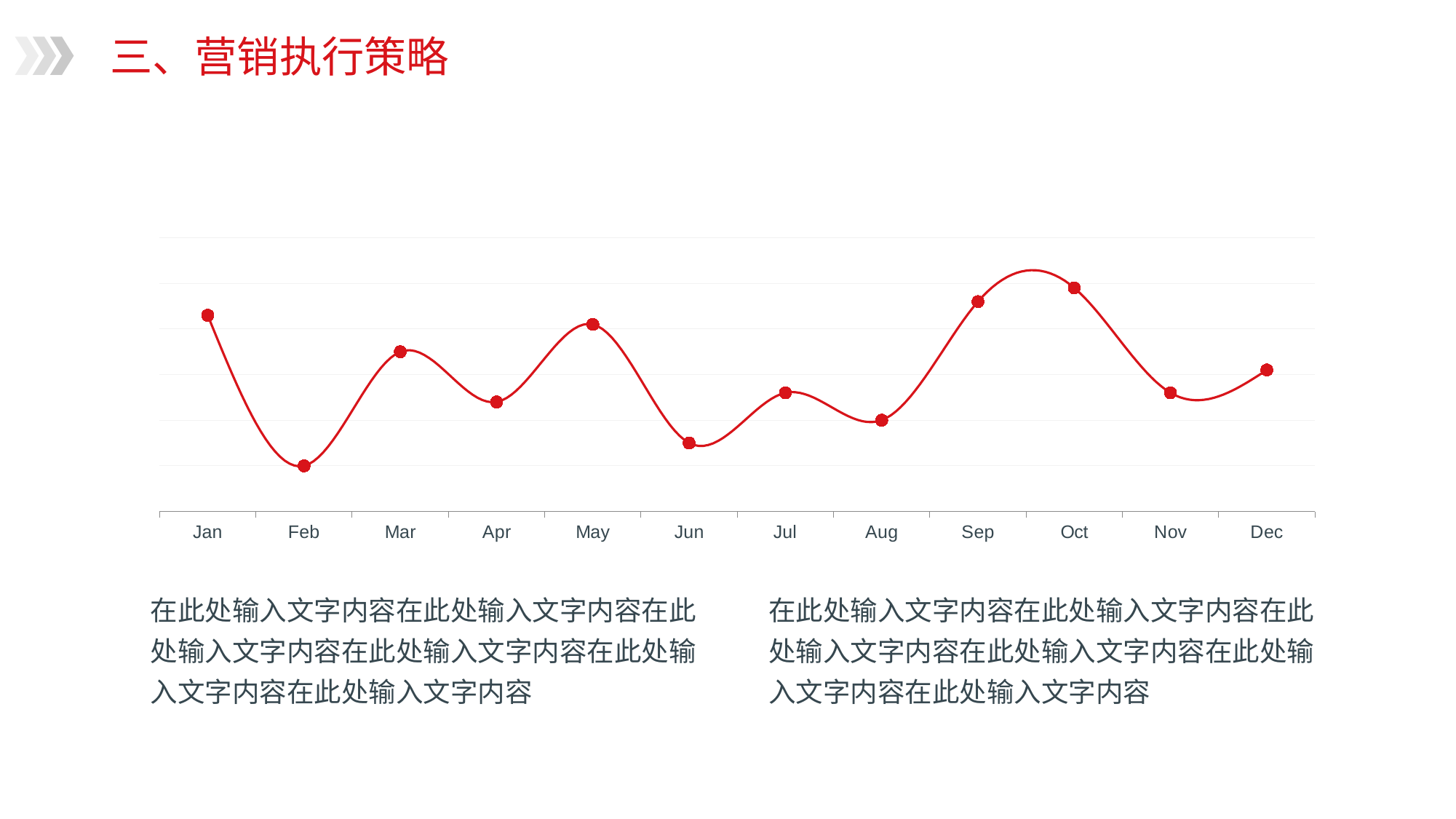
Does the line rise or fall from Oct to Nov? fall Which is larger, the value for Jan or the value for Feb? Jan Which month has the lowest value on the chart? Feb Which month has the highest value on the chart? Oct Does the line rise or fall from Jan to Feb? fall Does the line rise or fall from Aug to Oct? rise How many months are plotted along the x axis of the chart? 12 What colour is the line plotted on the chart? red What kind of chart is shown on the slide? line chart Which is larger, the value for May or the value for Jun? May Which is larger, the value for Sep or the value for Aug? Sep